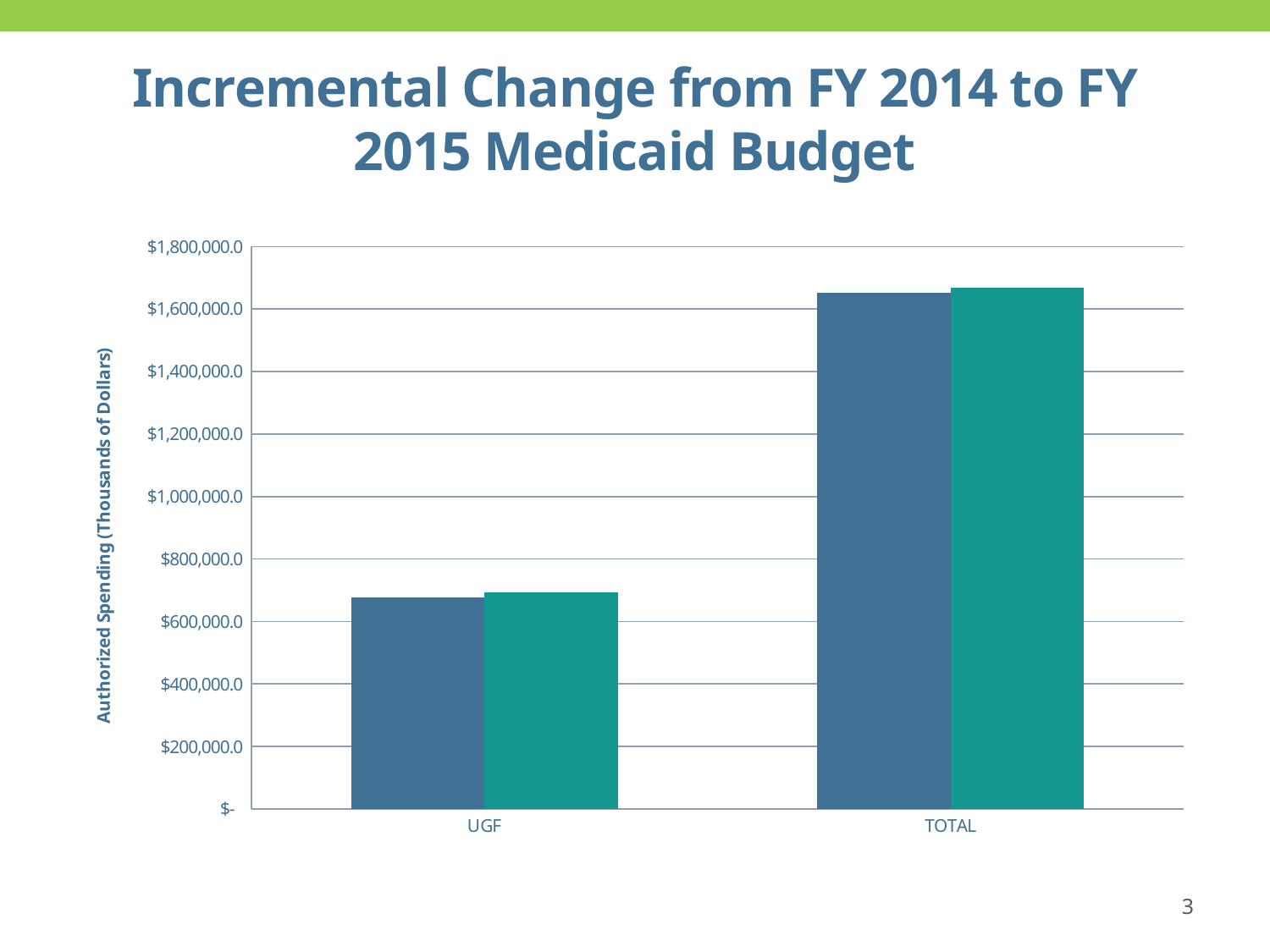
Which is larger, the value for UGF or the value for TOTAL? TOTAL What kind of chart is shown on the slide? bar chart Is the value of the teal bar for TOTAL greater or less than $1,800,000.0? less Which category has the highest bars, UGF or TOTAL? TOTAL What is the label on the vertical axis of the chart? Authorized Spending (Thousands of Dollars) How many bars are plotted in total on the chart? 4 Is the value of the teal bar for UGF greater or less than $800,000.0? less Is the value of the blue bar for TOTAL greater or less than $1,600,000.0? greater Which category has the lowest bars? UGF What is the title of the chart on the slide? Incremental Change from FY 2014 to FY 2015 Medicaid Budget How many categories are shown on the x axis? 2